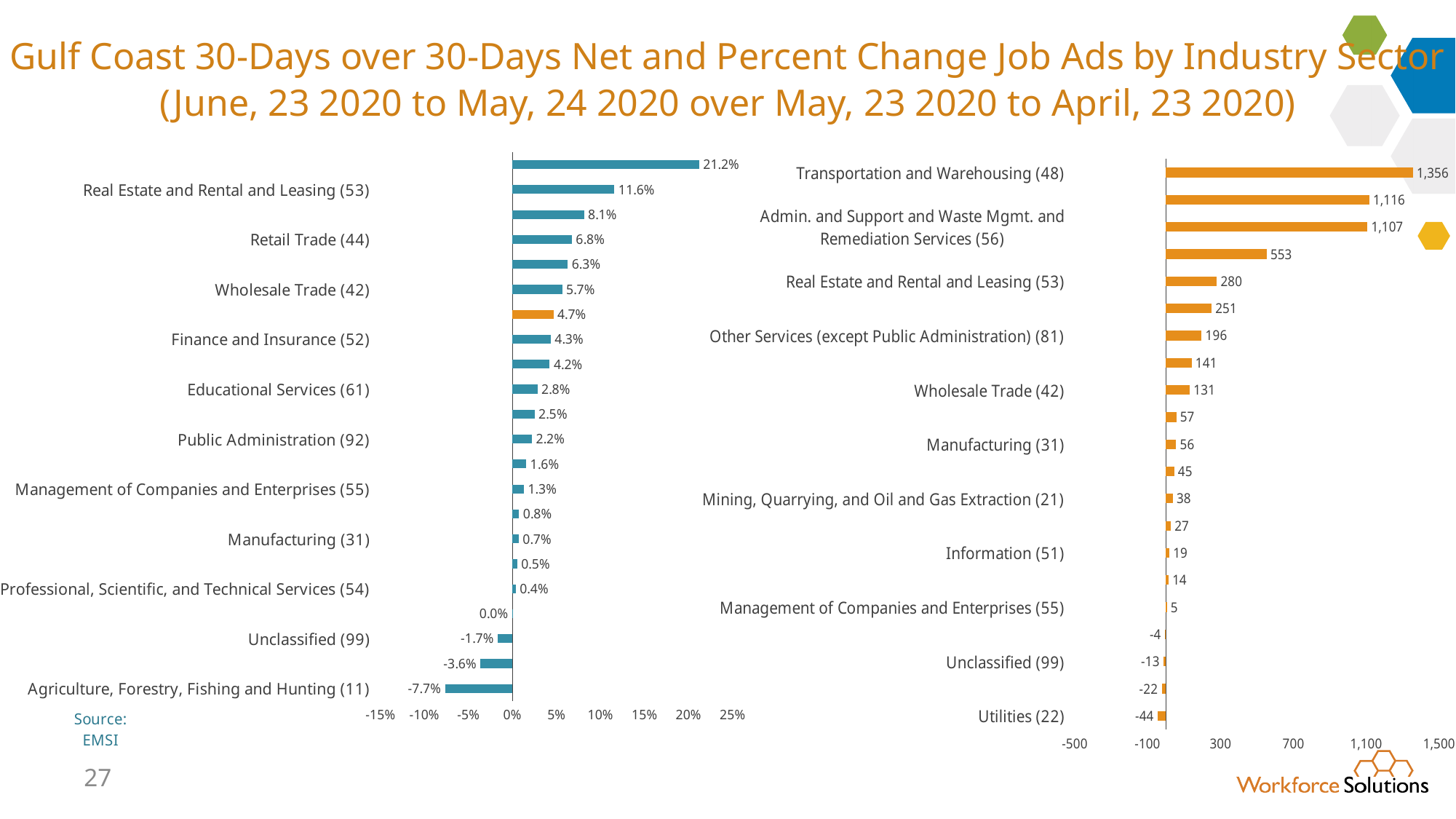
How many bars are plotted in the right chart (net change)? 21 In the right chart (net change), what is the value for Transportation and Warehousing (48)? 1,356 In the left chart (percent change), what is the value for Real Estate and Rental and Leasing (53)? 11.6% In the left chart (percent change), what is the value for Agriculture, Forestry, Fishing and Hunting (11)? -7.7% What type of chart is the left chart (percent change)? Bar chart In the right chart (net change), which labeled category has the highest value? Transportation and Warehousing (48) In the right chart (net change), what is the value for Utilities (22)? -44 In the left chart (percent change), which labeled category has the lowest value? Agriculture, Forestry, Fishing and Hunting (11) In the left chart (percent change), is the value for Wholesale Trade (42) greater or less than 5%? greater In the right chart (net change), which is larger: Wholesale Trade (42) or Manufacturing (31)? Wholesale Trade (42) In the right chart (net change), what is the difference between Transportation and Warehousing (48) and Admin. and Support and Waste Mgmt. and Remediation Services (56)? 249 In the left chart (percent change), what is the difference between Real Estate and Rental and Leasing (53) and Retail Trade (44)? 4.8%